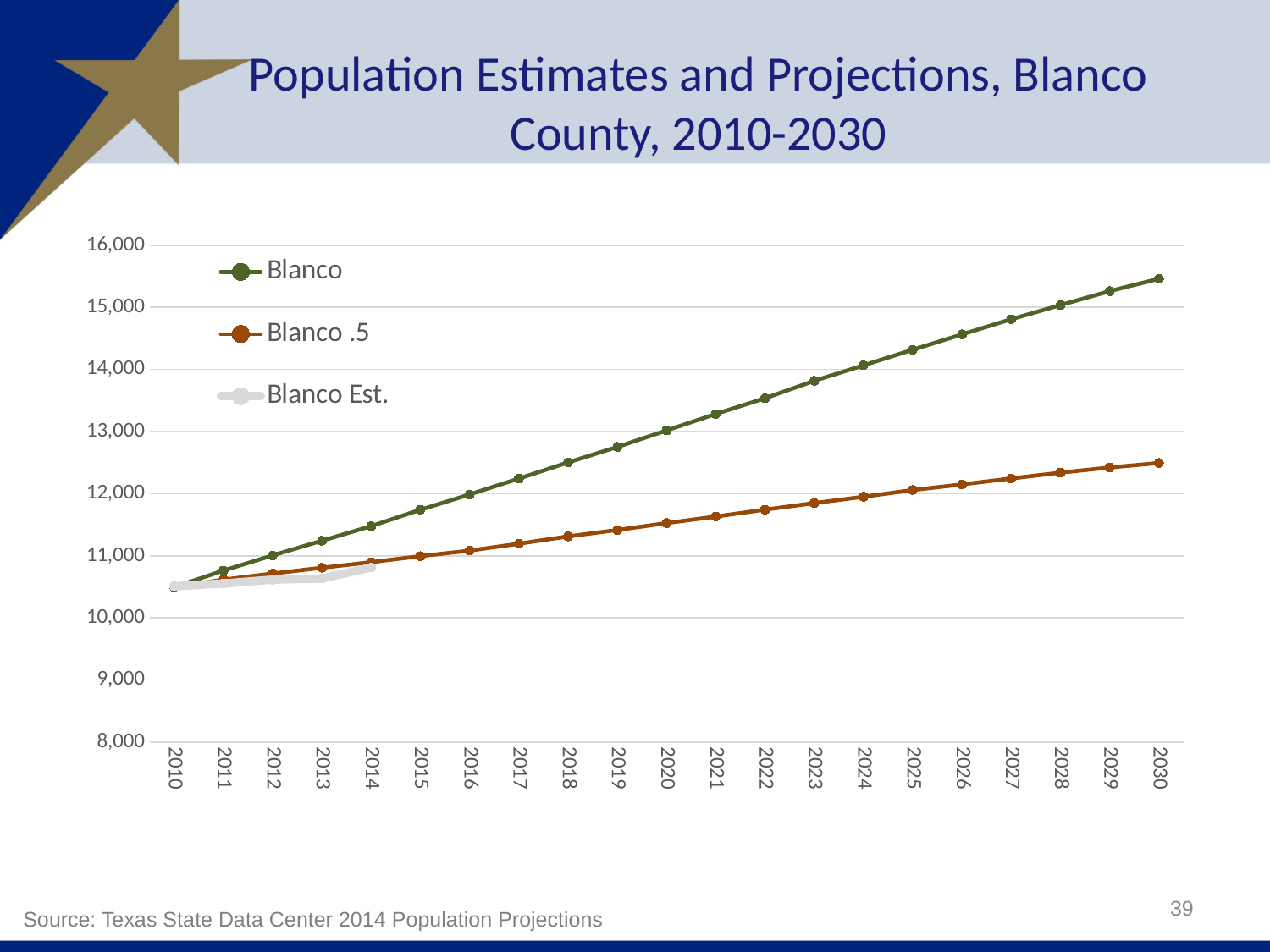
Does the Blanco .5 series rise or fall from 2010 to 2030? rise How many years are shown along the x axis? 21 Is the value for Blanco in 2025 greater or less than 14,000? greater In 2030, which series has the larger value, Blanco or Blanco .5? Blanco How many series does the legend list? 3 Does the Blanco series rise or fall from 2010 to 2030? rise What kind of chart is shown on the slide? line chart In which year does the Blanco series reach its highest value? 2030 Is the value for Blanco .5 in 2030 greater or less than 13,000? less Is the value for Blanco .5 in 2020 greater or less than 11,000? greater What is the title of the chart? Population Estimates and Projections, Blanco County, 2010-2030